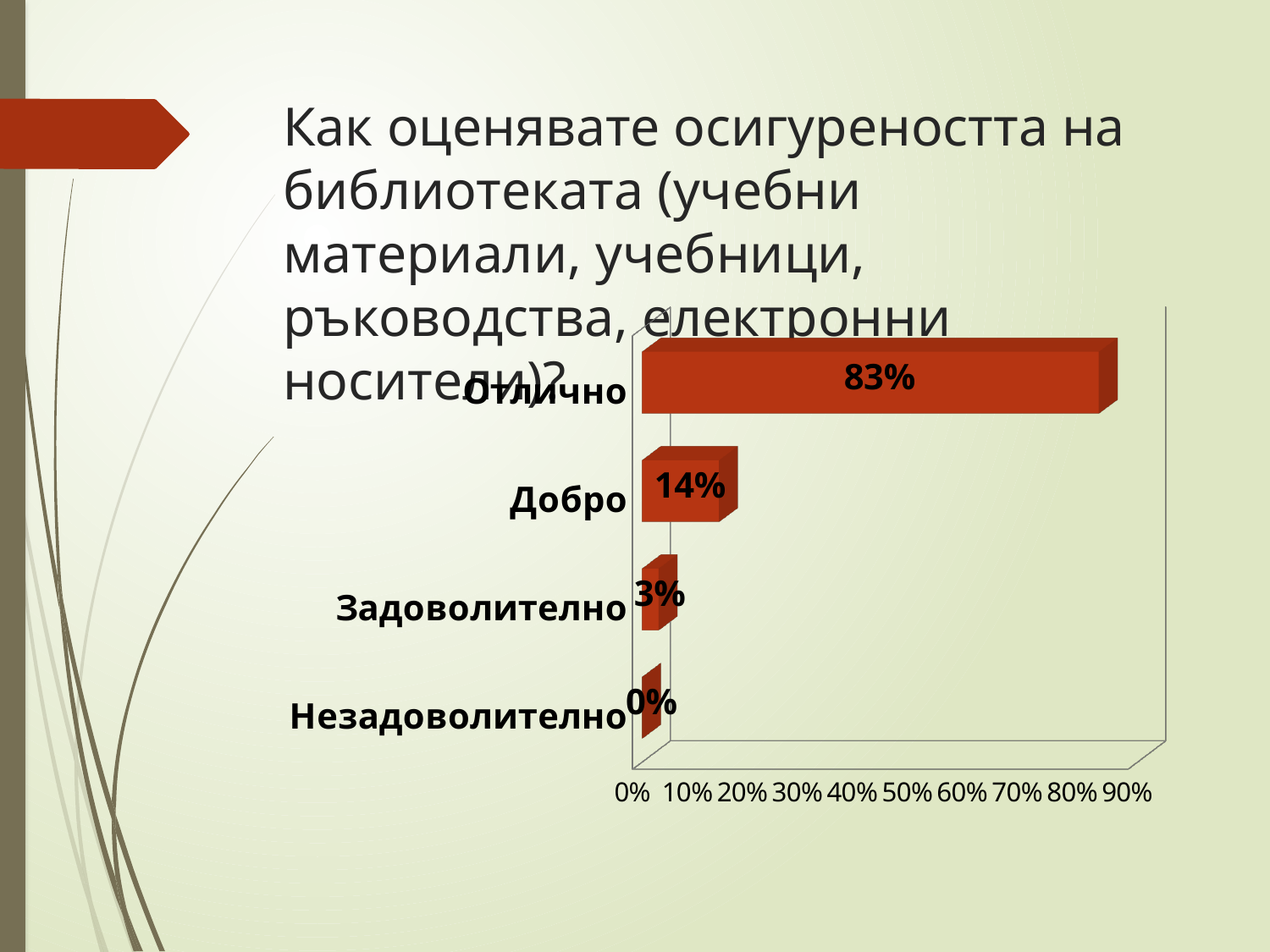
What is the value for Отлично? 83% What is the value for Незадоволително? 0% How many categories are shown in the chart? 4 What is the value for Задоволително? 3% What kind of chart is shown on the slide? bar chart What is the difference between the values for Добро and Задоволително? 11% Which category has the lowest value? Незадоволително Which is larger, the value for Добро or the value for Задоволително? Добро What is the difference between the values for Отлично and Добро? 69% Is the value for Отлично greater or less than 80%? greater What is the value for Добро? 14% Which category has the highest value? Отлично